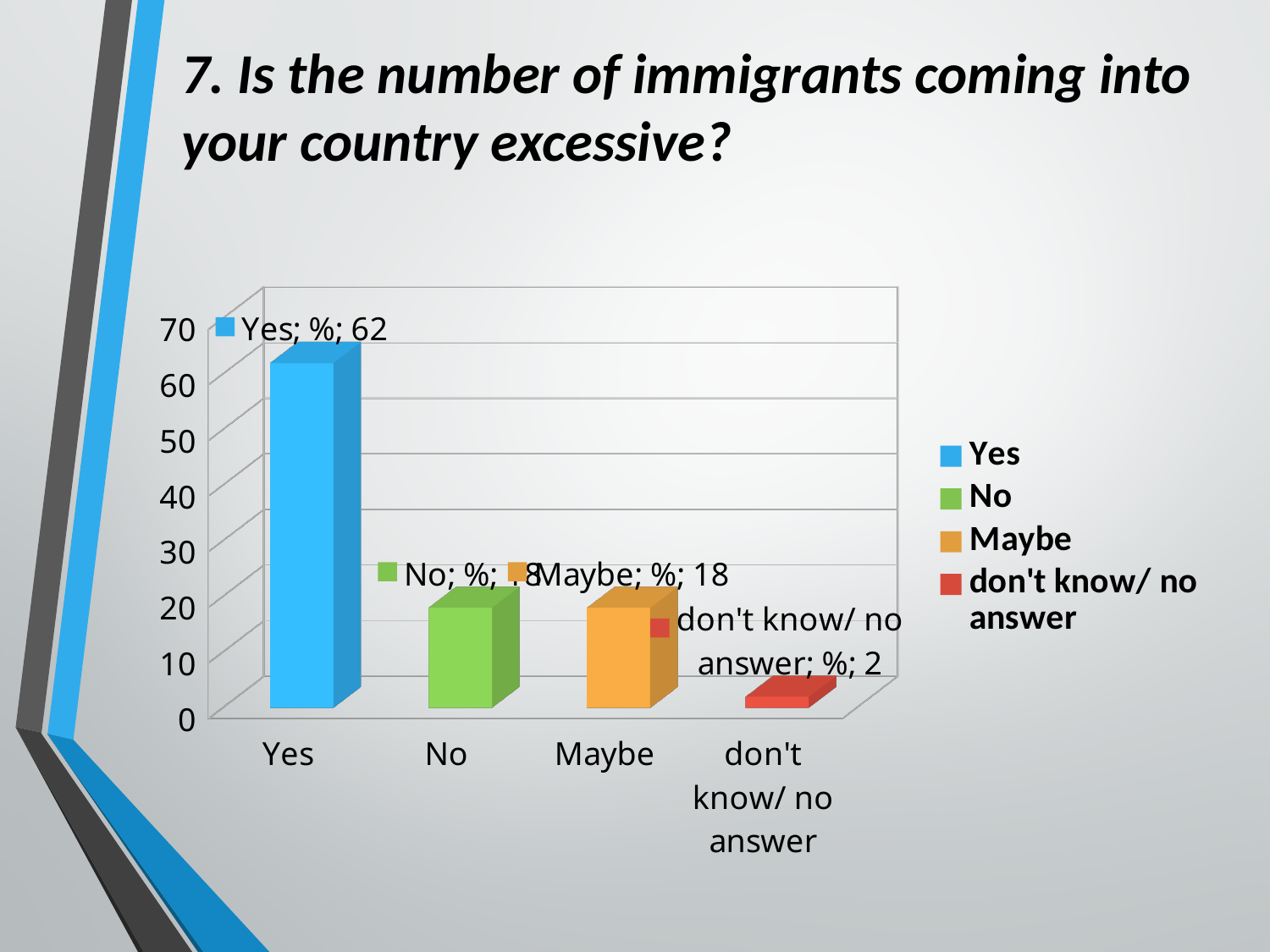
What is the value for Yes? 62 What kind of chart is shown on the slide? bar chart What is the difference between the values for Yes and Maybe? 44 What is the difference between the values for Maybe and don't know/ no answer? 16 Which is larger, the value for Yes or the value for Maybe? Yes Which category has the highest value? Yes How many categories are shown on the x axis? 4 What is the value for Maybe? 18 Which category has the lowest value? don't know/ no answer How many entries does the legend list? 4 What is the value for don't know/ no answer? 2 Is the value for No greater or less than 10? greater